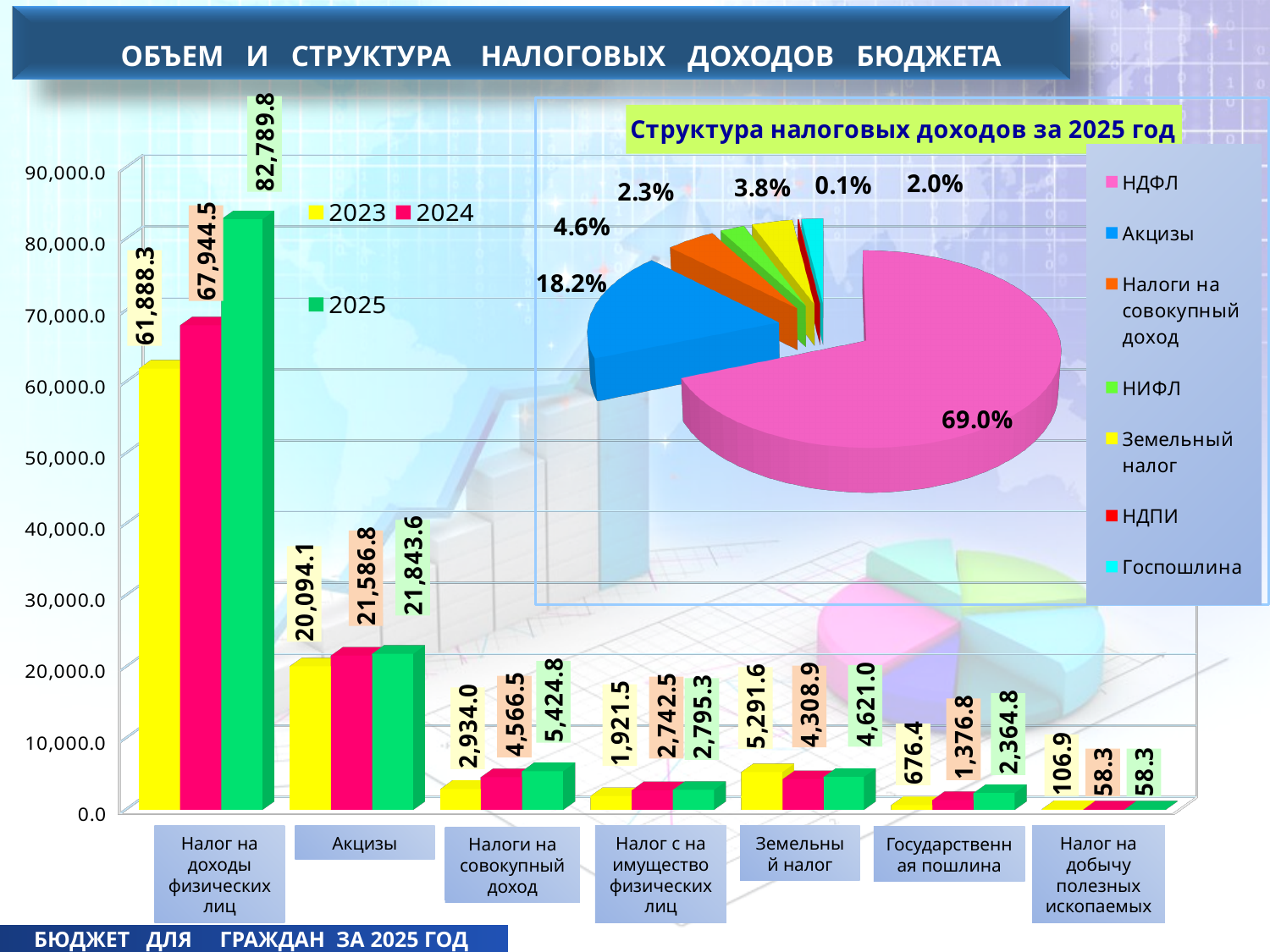
In the bar chart, what is the difference between the 2025 and 2024 values for Налог на доходы физических лиц? 14,845.3 In the bar chart, do the values for Государственная пошлина rise or fall from 2023 to 2025? rise In the pie chart Структура налоговых доходов за 2025 год, which category has the smallest share? НДПИ In the bar chart, which is larger for Земельный налог: the 2023 value or the 2025 value? 2023 In the pie chart Структура налоговых доходов за 2025 год, what share does НДФЛ have? 69.0% In the bar chart, which category has the lowest 2023 value? Налог на добычу полезных ископаемых In the bar chart, what is the 2023 value for Акцизы? 20,094.1 In the bar chart, what is the 2024 value for Государственная пошлина? 1,376.8 In the bar chart, which category has the highest 2025 value? Налог на доходы физических лиц In the bar chart, how many series does the legend list? 3 In the bar chart, how many categories are shown on the x axis? 7 In the bar chart, what is the 2025 value for Налог на доходы физических лиц? 82,789.8